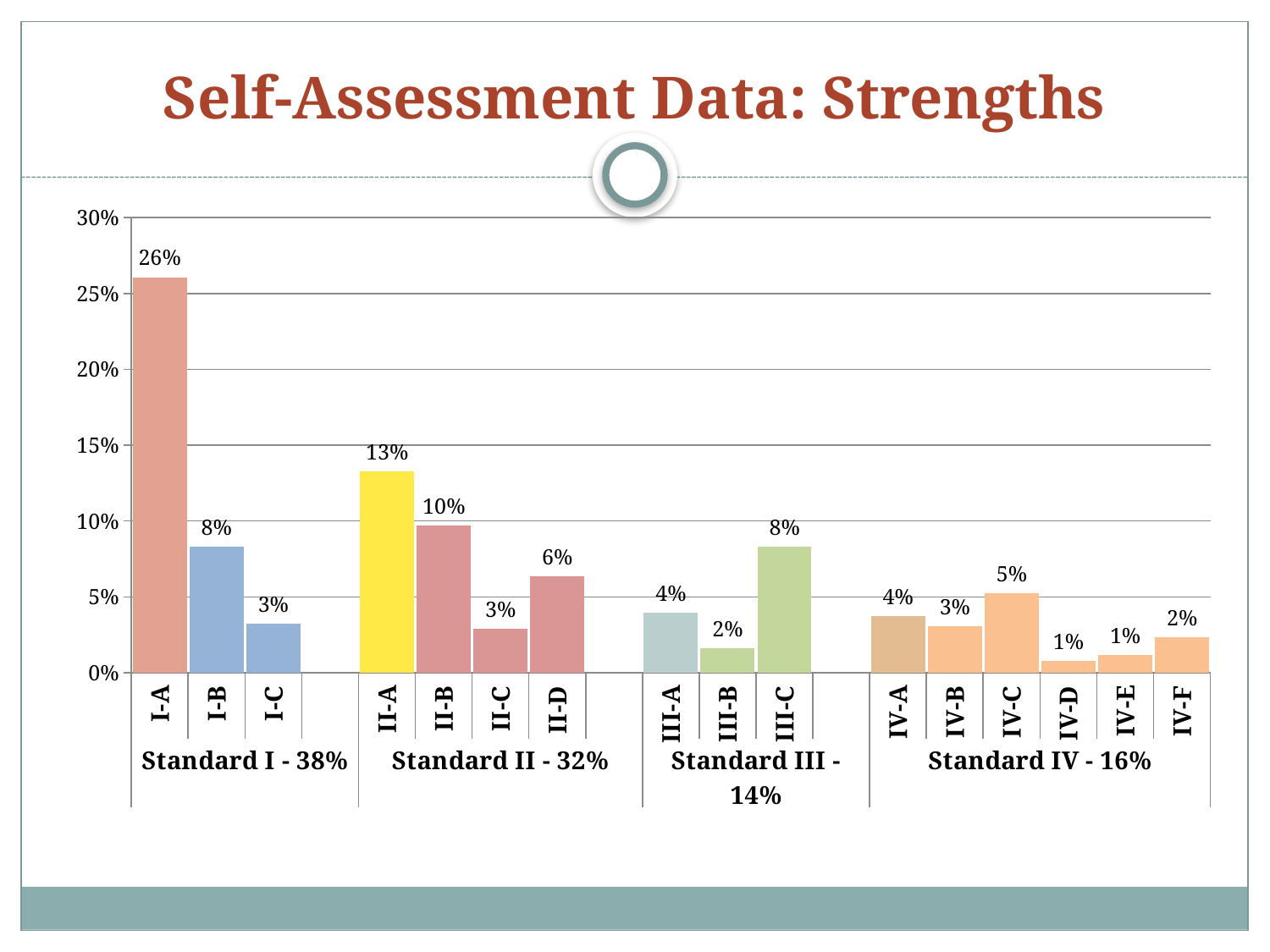
What percentage is shown for the Standard II group label? 32% What is the difference between the values for II-B and II-D? 4% Which is larger, the value for I-B or the value for III-C? They are equal (8%) What is the value for III-C? 8% What kind of chart is shown on the slide? Bar chart Which category has the highest value? I-A What is the value for IV-C? 5% What is the difference between the values for I-A and II-A? 13% What is the value for II-B? 10% Which is larger, the value for II-A or the value for IV-C? II-A How many categories (bars) are shown in the chart? 16 What is the value for I-A? 26%